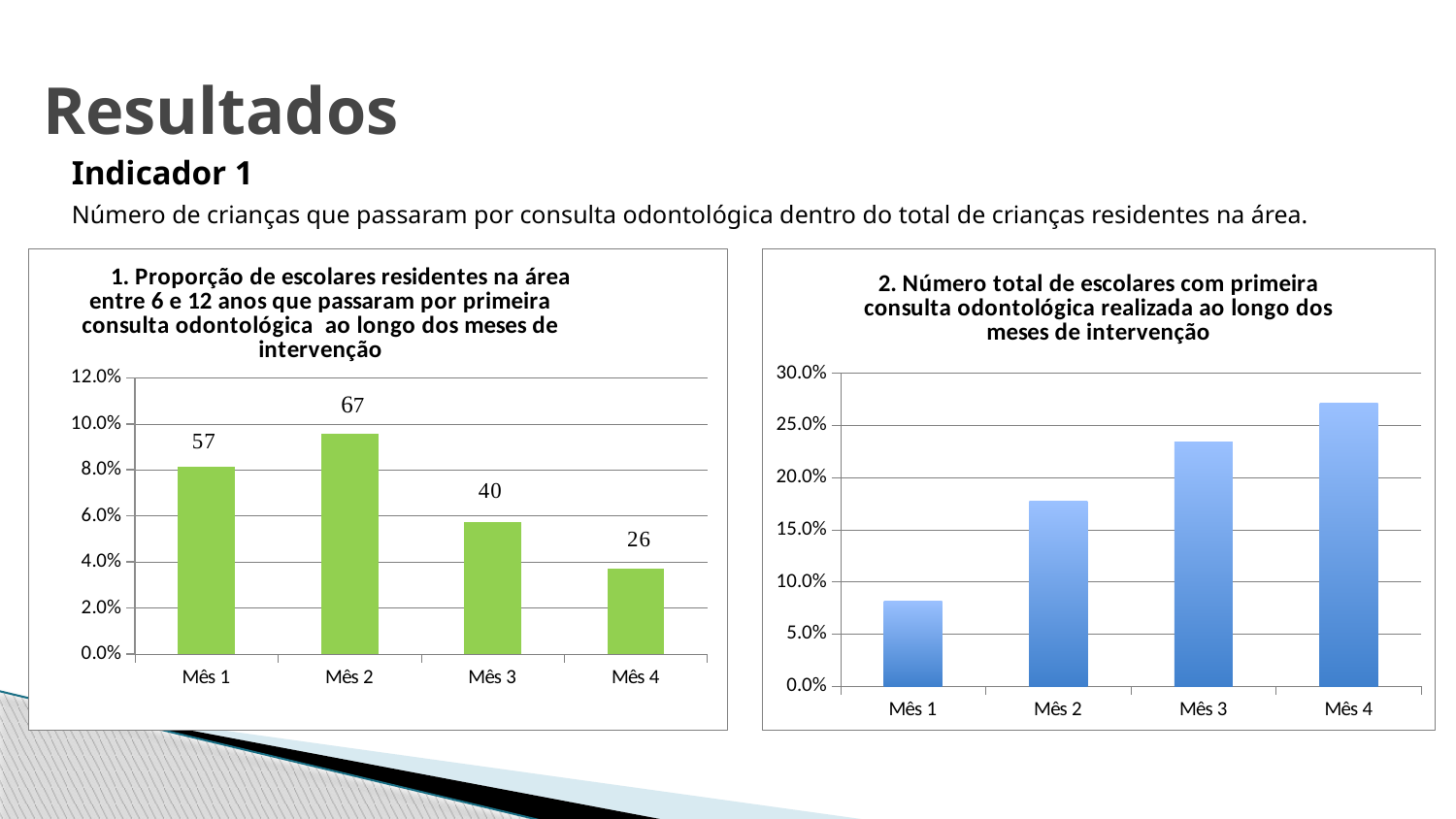
In the right chart (2. Número total de escolares com primeira consulta odontológica...), which month has the highest value? Mês 4 In the right chart (2. Número total de escolares com primeira consulta odontológica...), is the value for Mês 3 greater or less than 20.0%? greater In the right chart (2. Número total de escolares com primeira consulta odontológica...), do the values rise or fall from Mês 1 to Mês 4? rise In the left chart (1. Proporção de escolares residentes na área...), which month has the tallest bar? Mês 2 In the left chart (1. Proporção de escolares residentes na área...), what is the data label shown for Mês 2? 67 In the left chart (1. Proporção de escolares residentes na área...), which month has the shortest bar? Mês 4 In the left chart (1. Proporção de escolares residentes na área...), what is the data label shown for Mês 4? 26 In the left chart (1. Proporção de escolares residentes na área...), what is the difference between the data labels for Mês 2 and Mês 1? 10 In the right chart (2. Número total de escolares com primeira consulta odontológica...), is the value for Mês 1 greater or less than 10.0%? less What type of chart is the left chart (1. Proporção de escolares residentes na área...)? bar chart How many months (categories) are shown on the x axis of the right chart (2. Número total de escolares com primeira consulta odontológica...)? 4 In the left chart (1. Proporção de escolares residentes na área...), which has the larger data label, Mês 3 or Mês 4? Mês 3